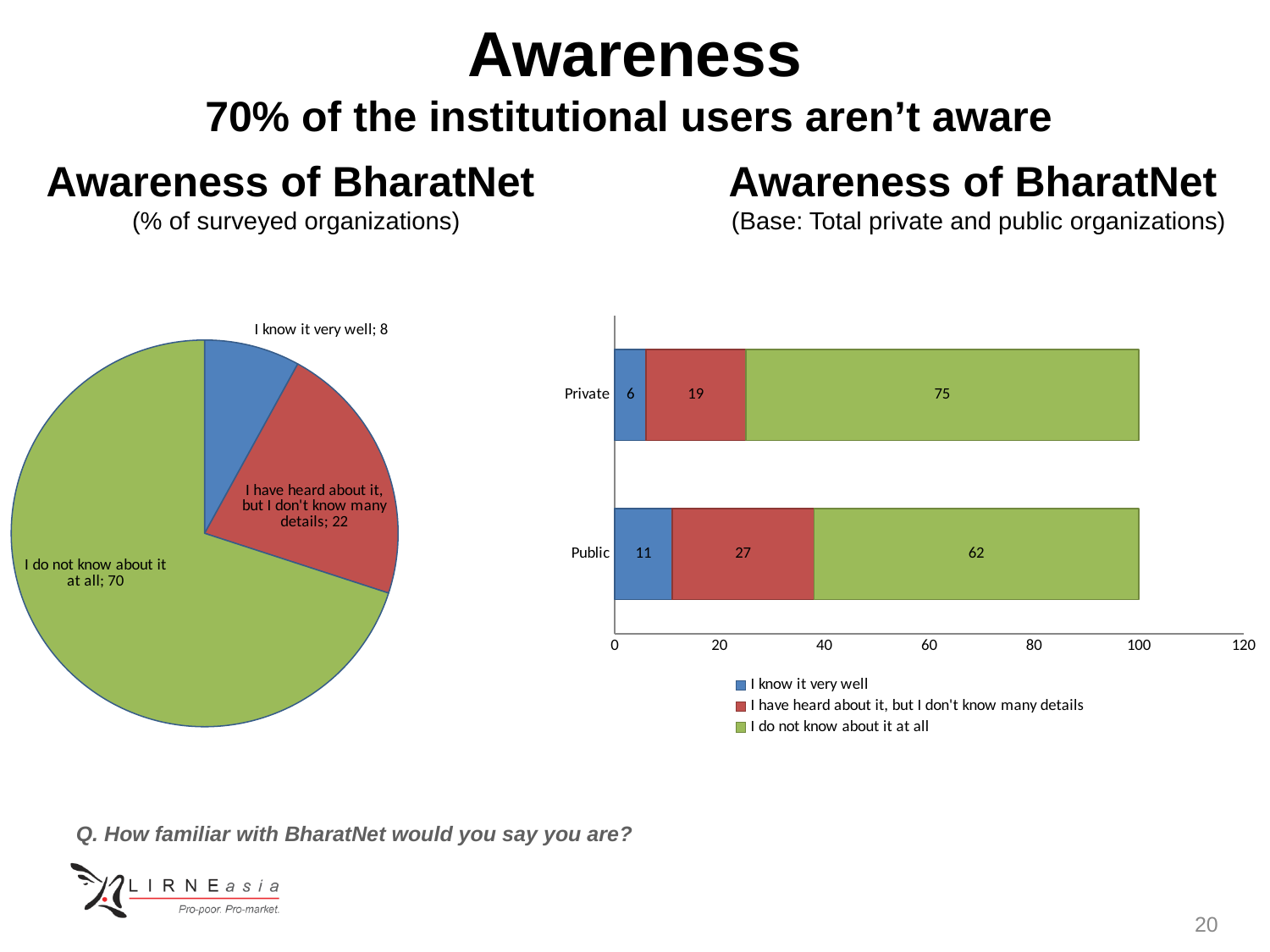
In the pie chart on the left, what is the value for 'I know it very well'? 8 In the pie chart on the left, how many slices are there? 3 In the bar chart on the right, what is the difference between the 'I know it very well' values for Public and Private? 5 What kind of chart is shown on the right side of the slide? Stacked bar chart In the bar chart on the right, which is larger for 'I do not know about it at all': Private or Public? Private In the pie chart on the left, which category has the largest slice? I do not know about it at all In the bar chart on the right, what is the value for 'I have heard about it, but I don't know many details' for Public? 27 In the pie chart on the left, what is the value for 'I do not know about it at all'? 70 In the bar chart on the right, what is the value for 'I do not know about it at all' for Private? 75 In the bar chart on the right, how many series does the legend list? 3 In the bar chart on the right, what is the total of the stacked bar for Public? 100 In the pie chart on the left, which category has the smallest slice? I know it very well